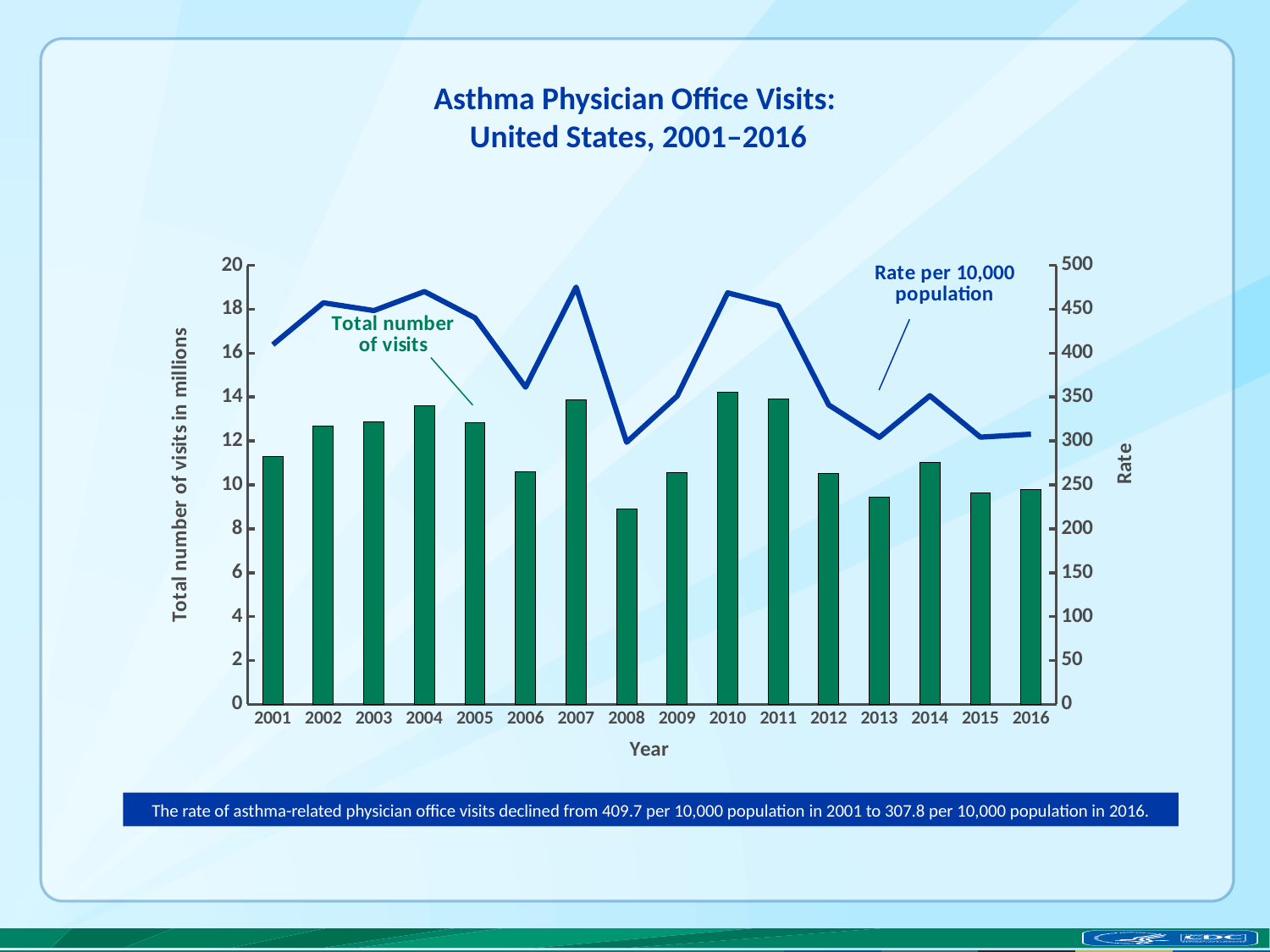
Is the rate per 10,000 population in 2007 greater or less than 450? greater Is the total number of visits in 2008 greater or less than 10 million? less Which year has the lowest bar for total number of visits? 2008 Overall, did the rate per 10,000 population rise or fall between 2001 and 2016? fall How many years are shown along the x axis of the chart? 16 What kind of chart is shown on the slide? A combined bar and line chart By how much did the rate per 10,000 population decline from 2001 to 2016? 101.9 What is the title of the chart? Asthma Physician Office Visits: United States, 2001–2016 What was the rate of asthma-related physician office visits per 10,000 population in 2016? 307.8 What was the rate of asthma-related physician office visits per 10,000 population in 2001? 409.7 Which is larger, the total number of visits in 2004 or in 2013? 2004 How many data series are plotted on the chart? 2